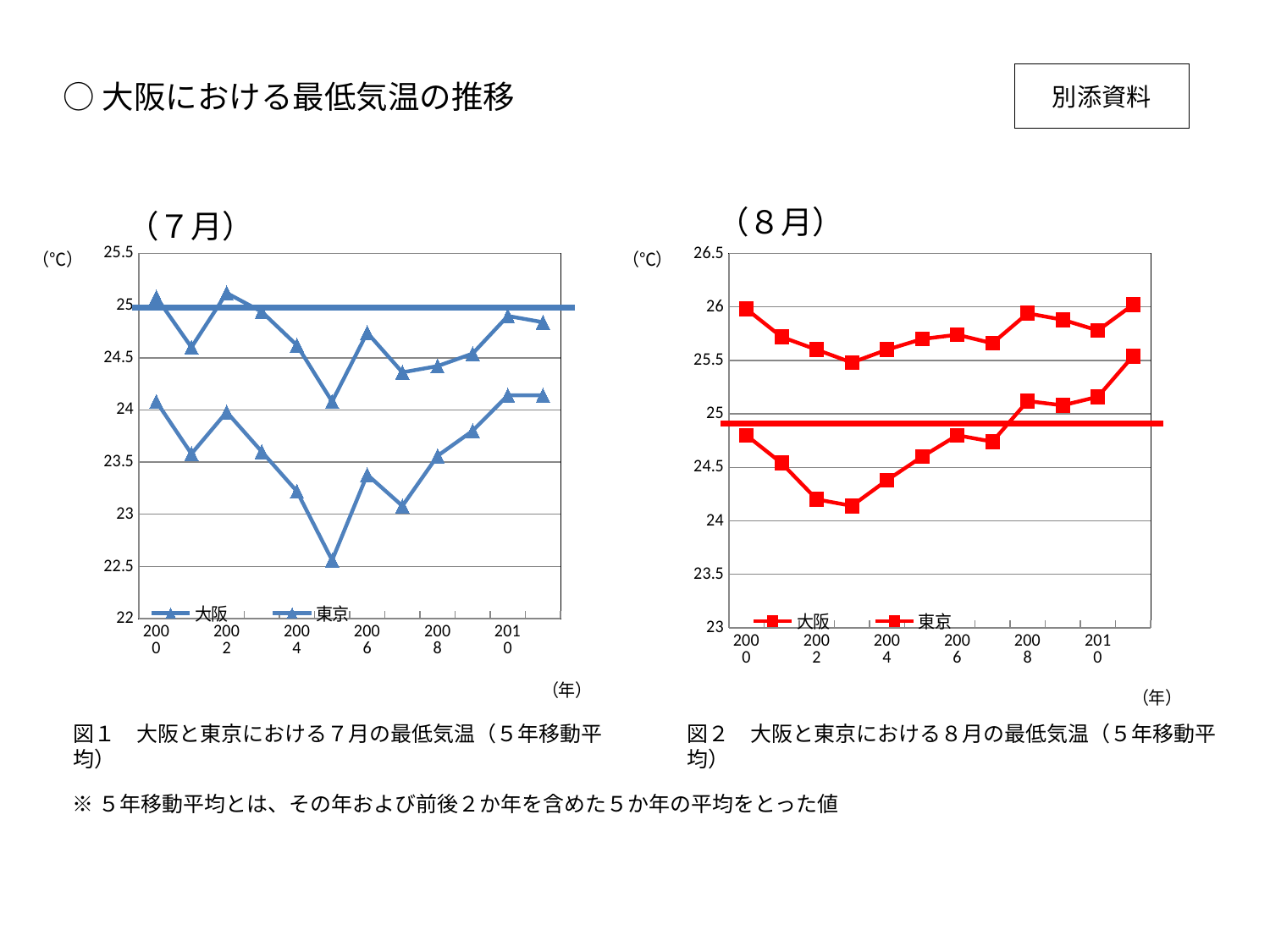
How many series does the legend of the August (８月) chart list? 2 How many years (data points per series) are plotted on the July (７月) chart? 12 In the July (７月) chart, is the lowest plotted value greater or less than 23? less In the August (８月) chart, is the lowest plotted value greater or less than 24.5? less What are the two legend entries on the August (８月) chart? 大阪, 東京 What unit is shown on the y axis of the August (８月) chart? ℃ In the August (８月) chart, is the highest plotted value greater or less than 25.5? greater In the August (８月) chart, in which year does the lower line reach its highest value? 2011 What kind of chart is the July (７月) chart on the left? line chart How many series does the legend of the July (７月) chart list? 2 In the August (８月) chart, does the lower line rise or fall from 2003 to 2011? rise In the July (７月) chart, in which year does the lower line reach its lowest value? 2005